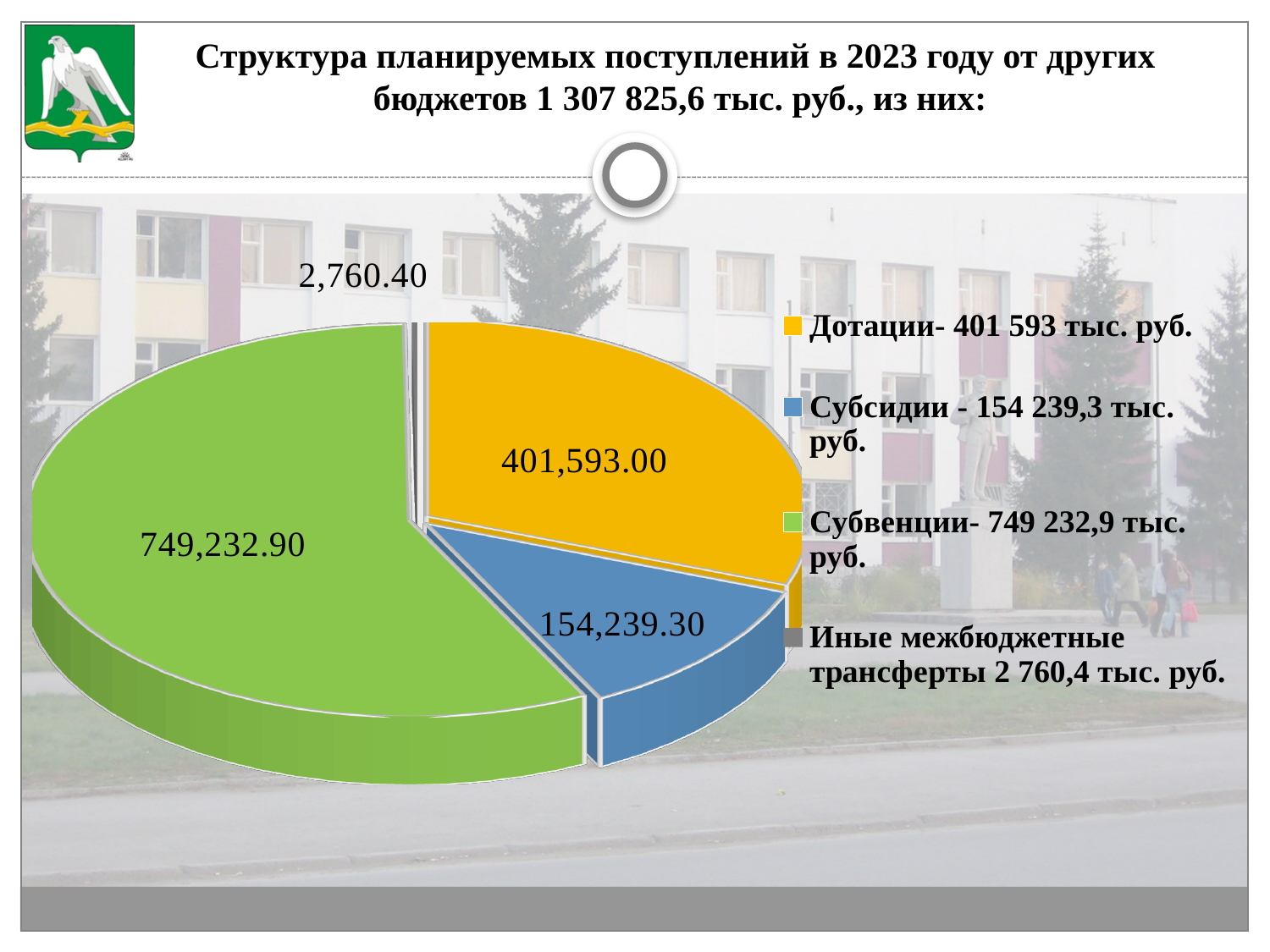
Which category has the largest slice of the pie? Субвенции What is the value shown for the Субсидии slice? 154,239.30 Which category has the smallest slice of the pie? Иные межбюджетные трансферты What colour is the Субвенции slice in the pie chart? Green What kind of chart is shown on the slide? Pie chart What is the value shown for the Иные межбюджетные трансферты slice? 2,760.40 What is the value shown for the Субвенции slice? 749,232.90 Which is larger, the Дотации slice or the Субсидии slice? Дотации How many slices does the pie chart have? 4 What is the difference between the Дотации value and the Субсидии value? 247,353.70 What is the difference between the Субвенции value and the Дотации value? 347,639.90 What is the value shown for the Дотации slice? 401,593.00